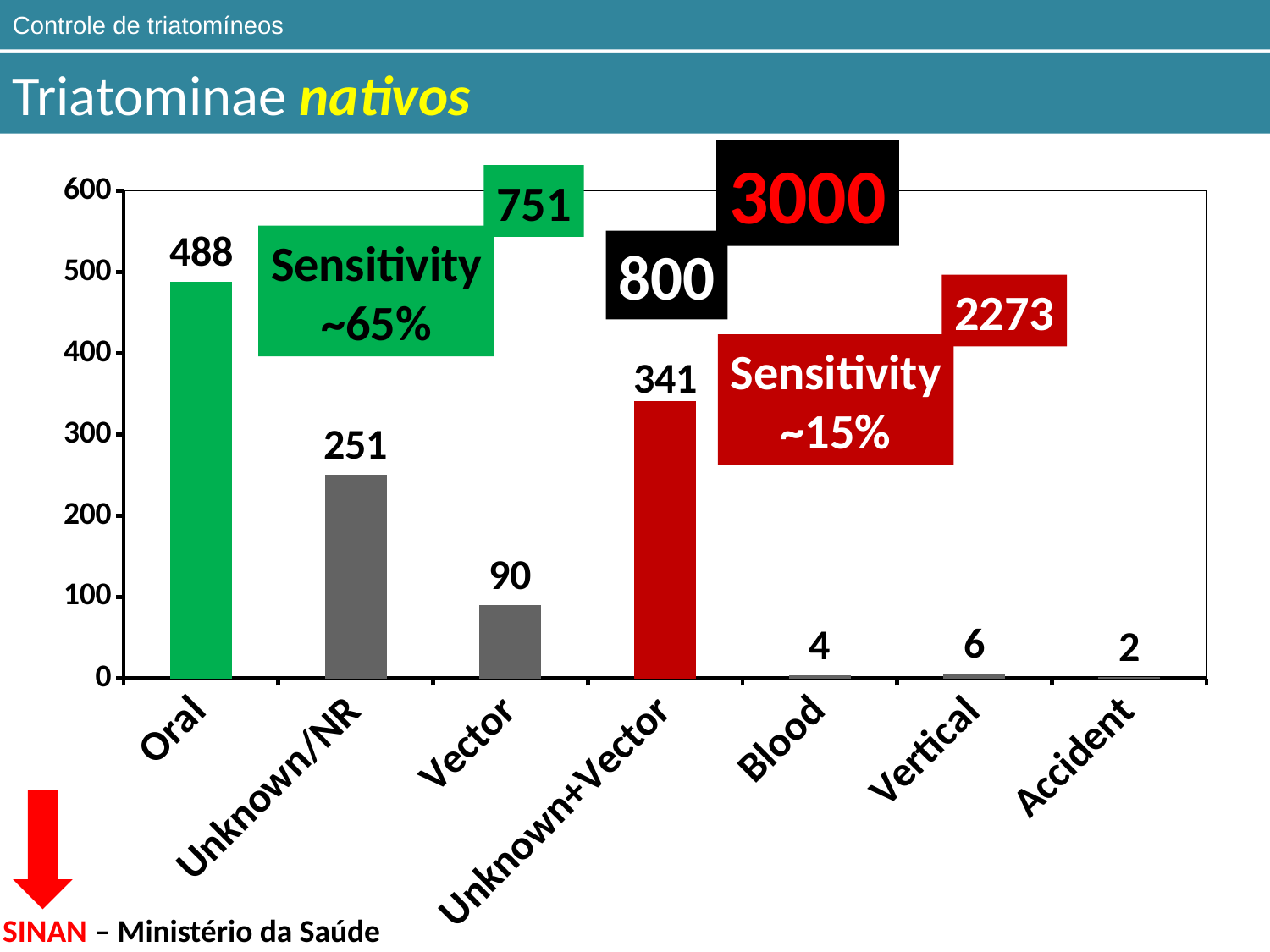
How many categories are shown on the x axis? 7 What colour is the bar for Unknown+Vector? Red What is the value for Vertical? 6 What kind of chart is shown on the slide? Bar chart Which category has the highest value? Oral What is the value for Unknown/NR? 251 What is the value for Vector? 90 What is the difference between the values for Oral and Unknown+Vector? 147 What is the value for Unknown+Vector? 341 Which category has the lowest value? Accident Which is larger, the value for Unknown/NR or the value for Vector? Unknown/NR What is the value for Oral? 488